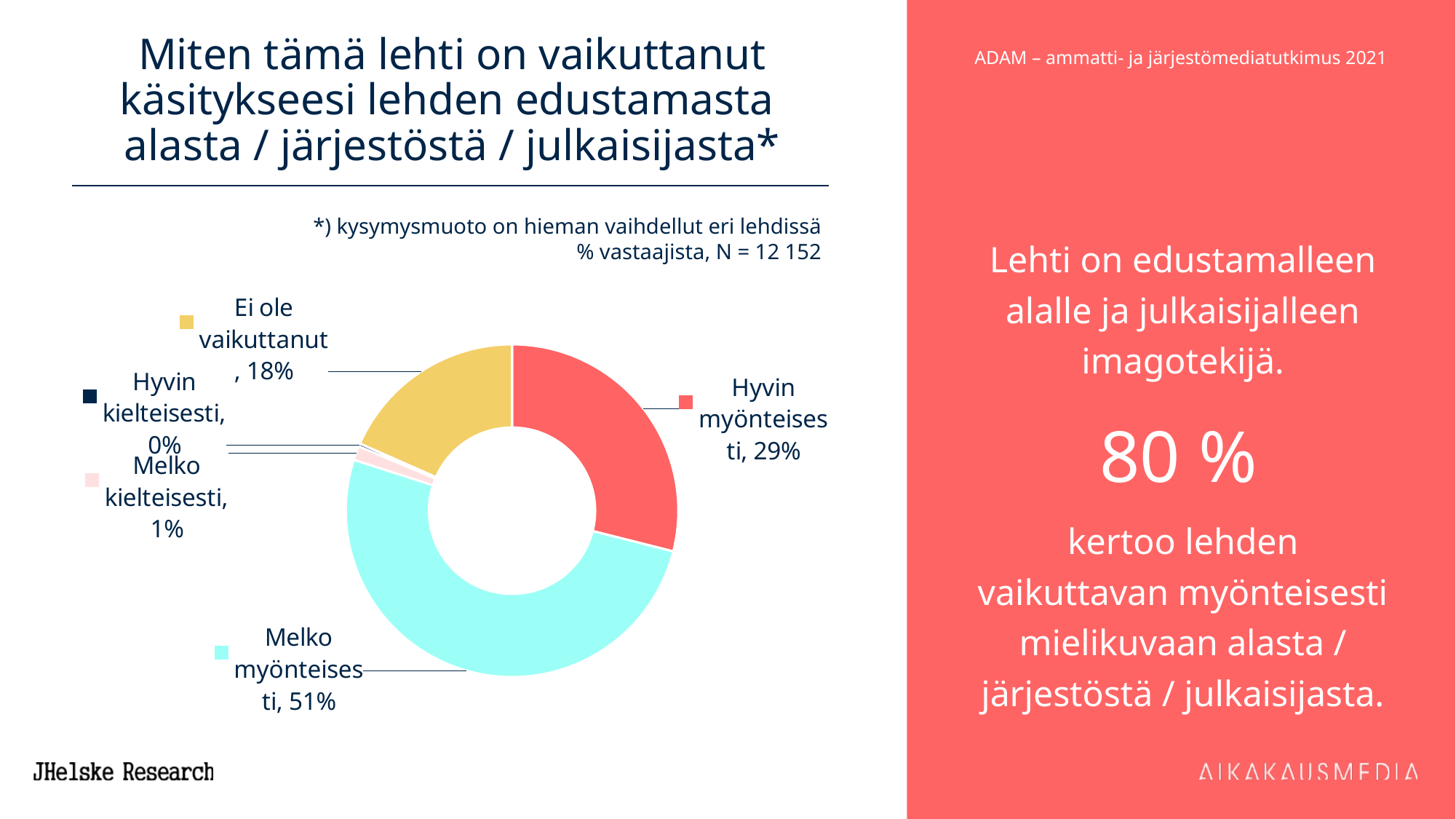
Which category has the largest share of the chart? Melko myönteisesti What percentage of respondents answered "Melko myönteisesti"? 51% What percentage of respondents answered "Hyvin myönteisesti"? 29% How many categories are shown in the chart? 5 What kind of chart is shown on the slide? Pie chart (donut) What percentage of respondents answered "Melko kielteisesti"? 1% What percentage of respondents answered "Hyvin kielteisesti"? 0% What is the number of respondents (N) stated above the chart? 12 152 Which is larger, the share for "Ei ole vaikuttanut" or the share for "Hyvin myönteisesti"? Hyvin myönteisesti Which category has the smallest share of the chart? Hyvin kielteisesti What is the difference in percentage points between "Melko myönteisesti" and "Hyvin myönteisesti"? 22 What percentage of respondents answered "Ei ole vaikuttanut"? 18%